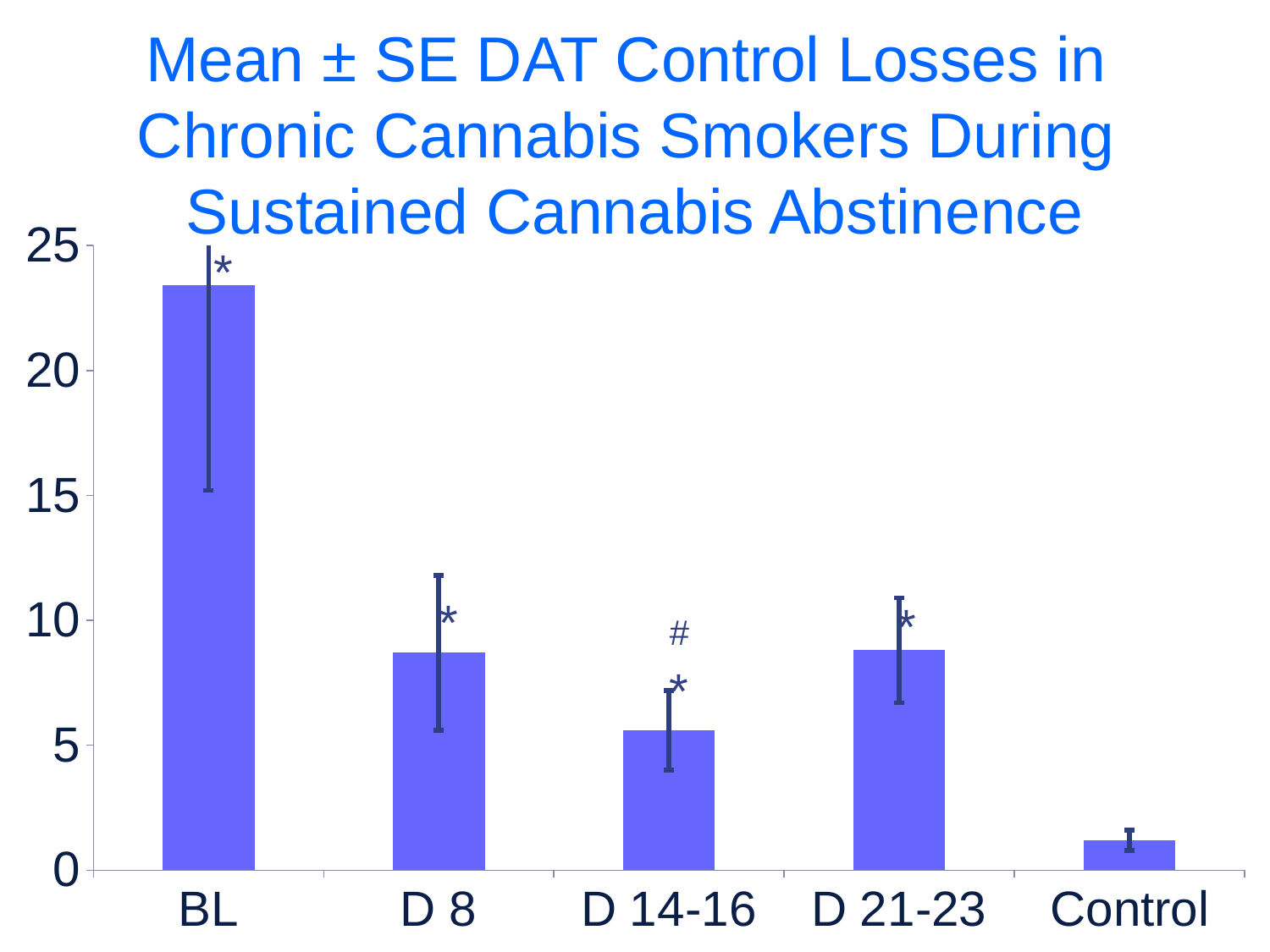
Which is larger, the value for D 14-16 or the value for Control? D 14-16 What is the title of the chart? Mean ± SE DAT Control Losses in Chronic Cannabis Smokers During Sustained Cannabis Abstinence Is the value for Control greater or less than 5? less Which category has the lowest value? Control What kind of chart is shown on the slide? bar chart Which category has the highest value? BL Is the value for BL greater or less than 20? greater Which is larger, the value for BL or the value for D 8? BL Which is larger, the value for D 8 or the value for D 14-16? D 8 Is the value for D 14-16 greater or less than 5? greater How many categories are shown on the x axis? 5